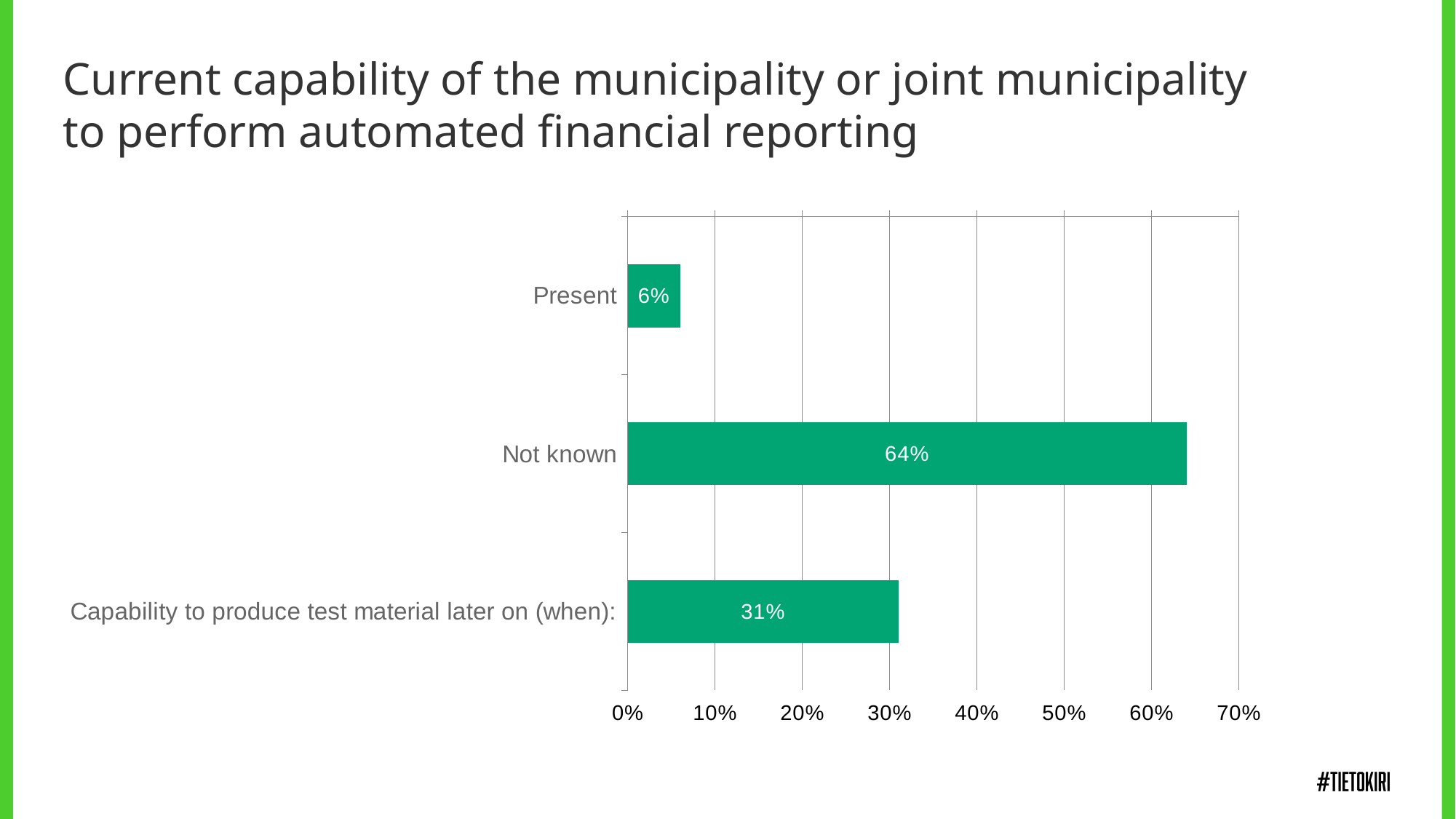
How many categories are shown in the chart? 3 What kind of chart is shown on the slide? bar chart What is the difference between the values for Not known and Capability to produce test material later on (when):? 33% Is the value for Not known greater or less than 60%? greater What is the value for Capability to produce test material later on (when):? 31% What is the title of the slide? Current capability of the municipality or joint municipality to perform automated financial reporting Which category has the lowest value? Present Which category has the highest value? Not known What is the difference between the values for Not known and Present? 58% What is the value for Present? 6% Which is larger, the value for Present or the value for Capability to produce test material later on (when):? Capability to produce test material later on (when): What is the value for Not known? 64%